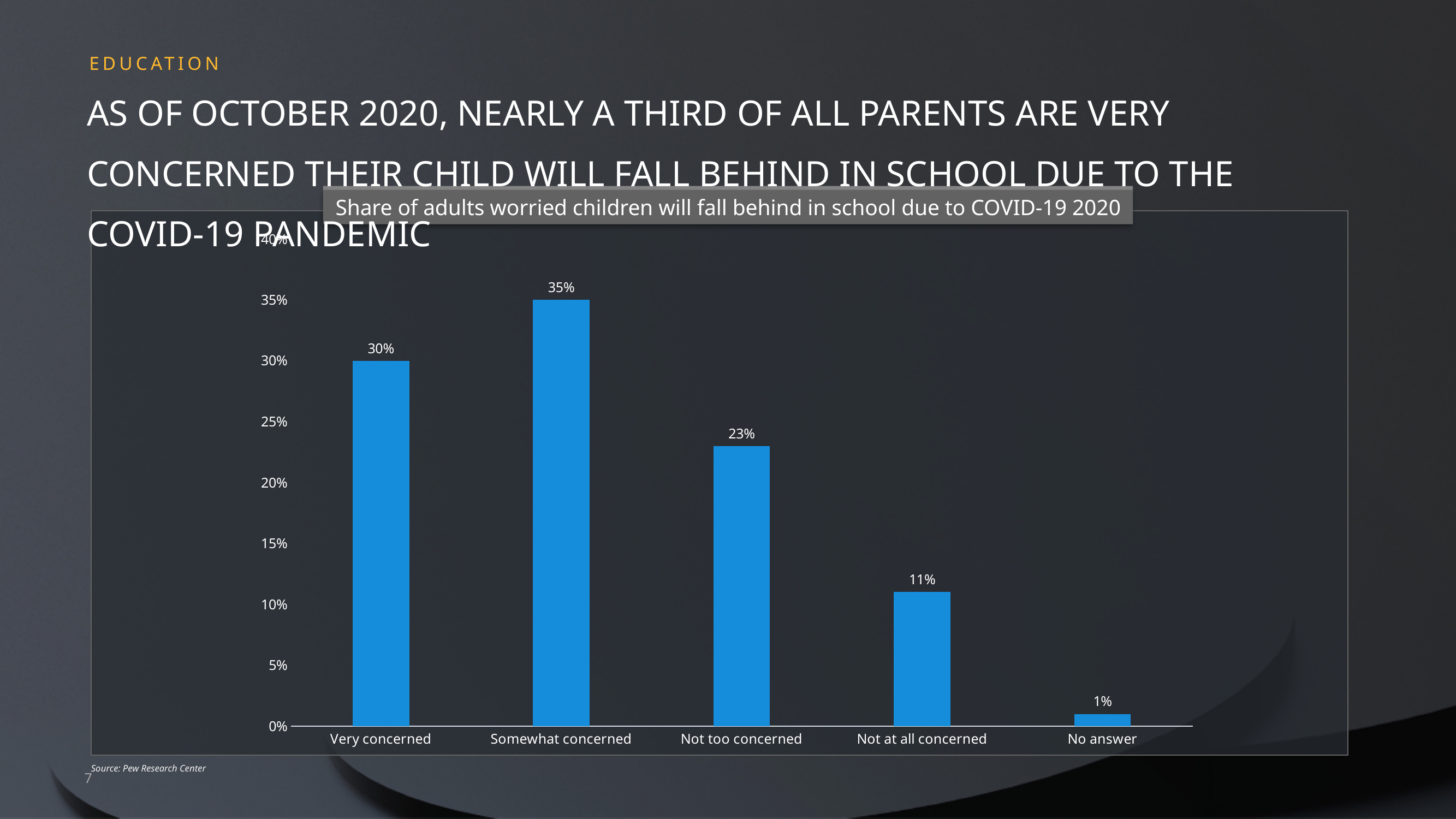
Which category has the lowest value? No answer What is the value for Very concerned? 30% What is the value for Not at all concerned? 11% What is the value for Somewhat concerned? 35% What is the title of the chart? Share of adults worried children will fall behind in school due to COVID-19 2020 What is the difference between the values for Somewhat concerned and Very concerned? 5% How many categories are shown on the x axis? 5 Which category has the highest value? Somewhat concerned Which is larger, the value for Not too concerned or the value for Not at all concerned? Not too concerned What kind of chart is shown on the slide? Bar chart What is the value for No answer? 1% What is the value for Not too concerned? 23%